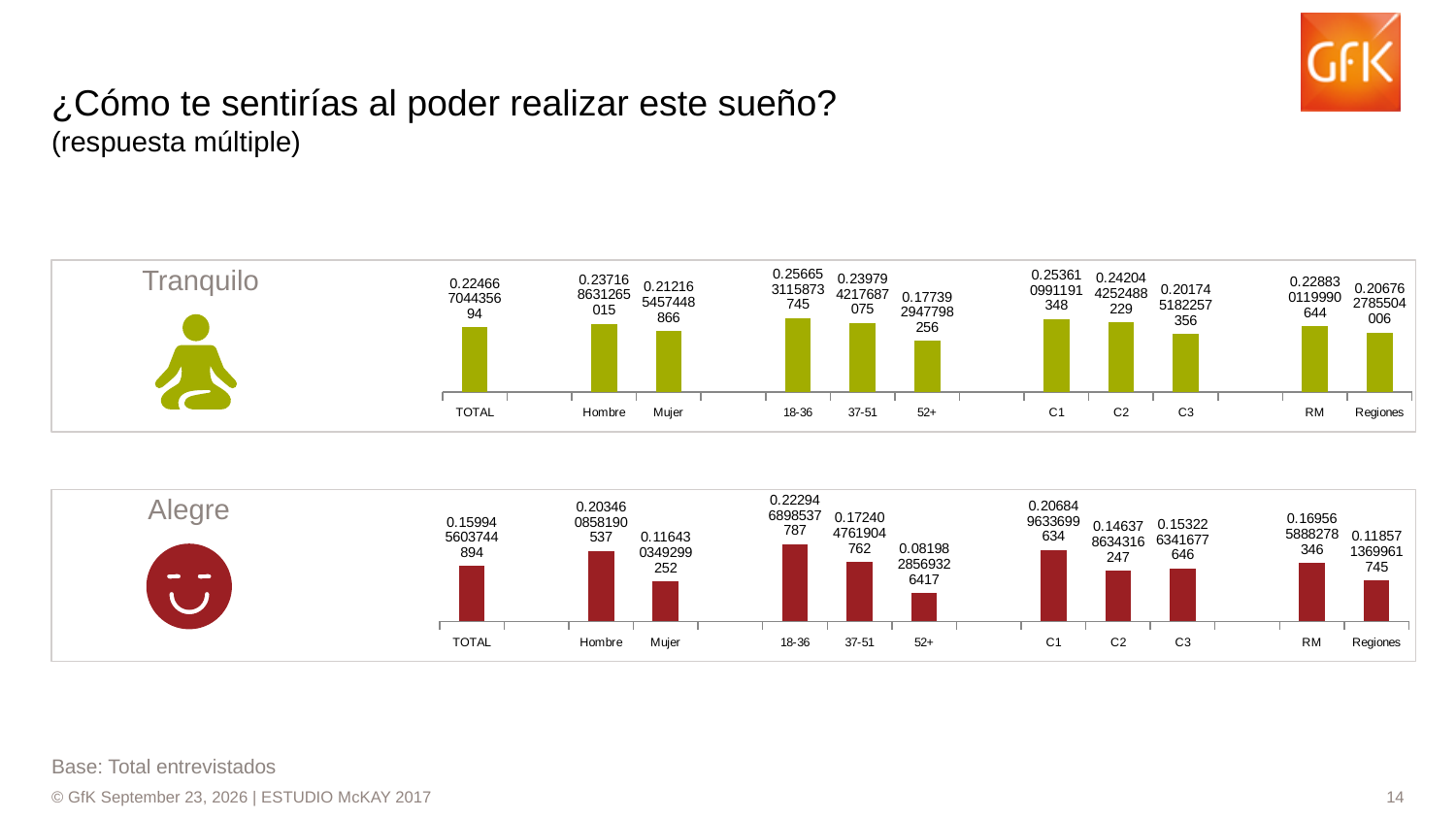
What colour are the bars in the Alegre chart? Red In the Alegre chart, which category has the lowest value? 52+ In the Alegre chart, what is the value for 52+? 0.0819828569326417 In the Alegre chart, do the values rise or fall across the age groups from 18-36 to 52+? Fall In the Tranquilo chart, which is larger, the value for Hombre or the value for Mujer? Hombre In the Tranquilo chart, what is the value for TOTAL? 0.224667044356994 In the Alegre chart, which category has the highest value? 18-36 In the Alegre chart, which is larger, the value for RM or the value for Regiones? RM What kind of chart is the Alegre chart? Bar chart In the Alegre chart, what is the value for Hombre? 0.203460858190537 In the Tranquilo chart, which category has the lowest value? 52+ How many categories are shown on the x axis of the Tranquilo chart? 11